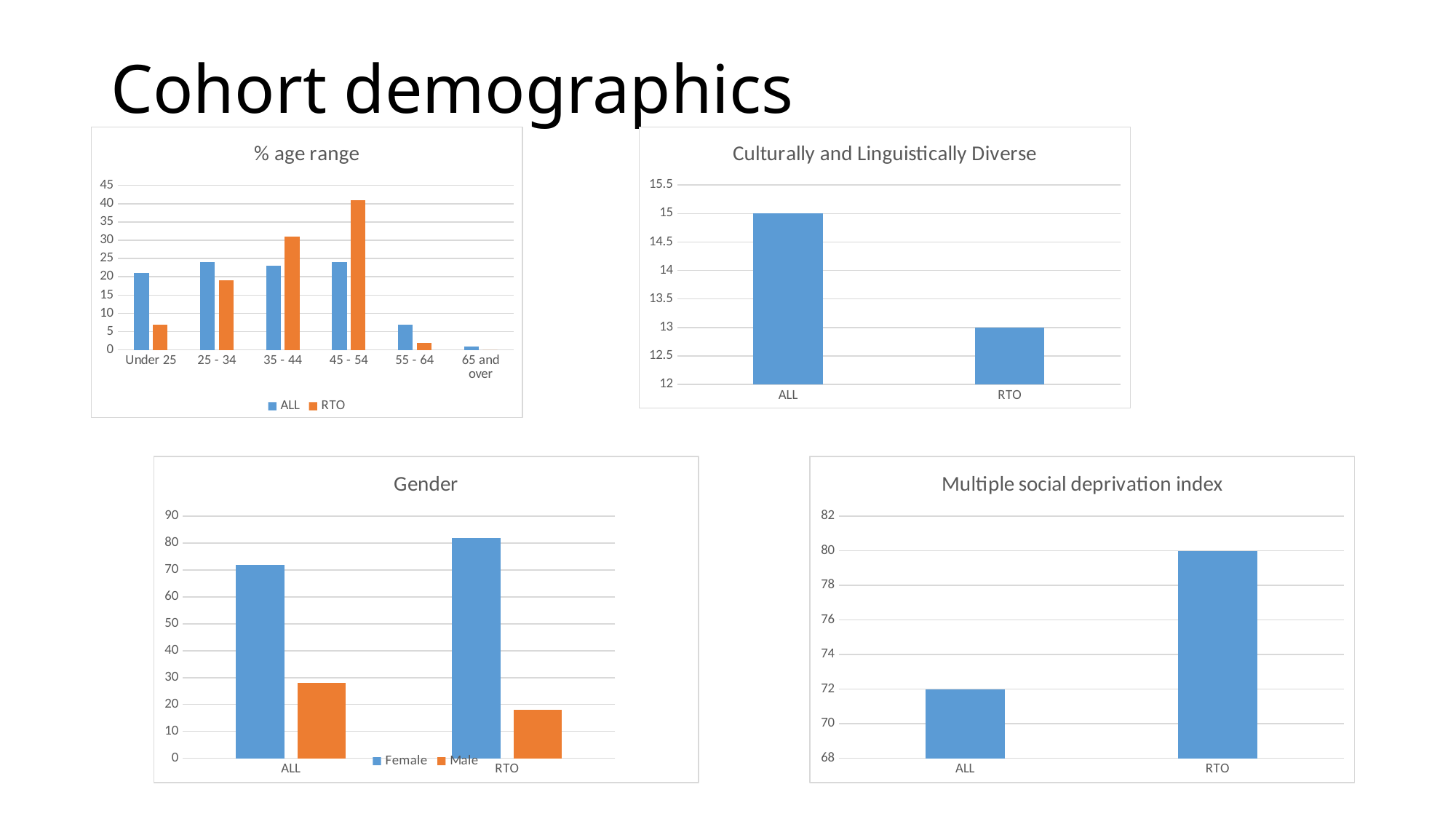
In the 'Multiple social deprivation index' chart, what is the value for RTO? 80 In the 'Gender' chart, is the Male value for ALL greater or less than 30? less In the 'Culturally and Linguistically Diverse' chart, what is the value for ALL? 15 In the 'Culturally and Linguistically Diverse' chart, which category is higher, ALL or RTO? ALL How many series does the legend of the 'Gender' chart list? 2 How many age categories are shown in the '% age range' chart? 6 In the '% age range' chart, which age category has the highest RTO value? 45 - 54 In the '% age range' chart, is the RTO value for 45 - 54 greater or less than 40? greater In the 'Multiple social deprivation index' chart, what is the difference between the RTO and ALL values? 8 In the 'Multiple social deprivation index' chart, which category has the lowest value? ALL In the 'Culturally and Linguistically Diverse' chart, what is the value for RTO? 13 What kind of chart is the 'Gender' chart? bar chart